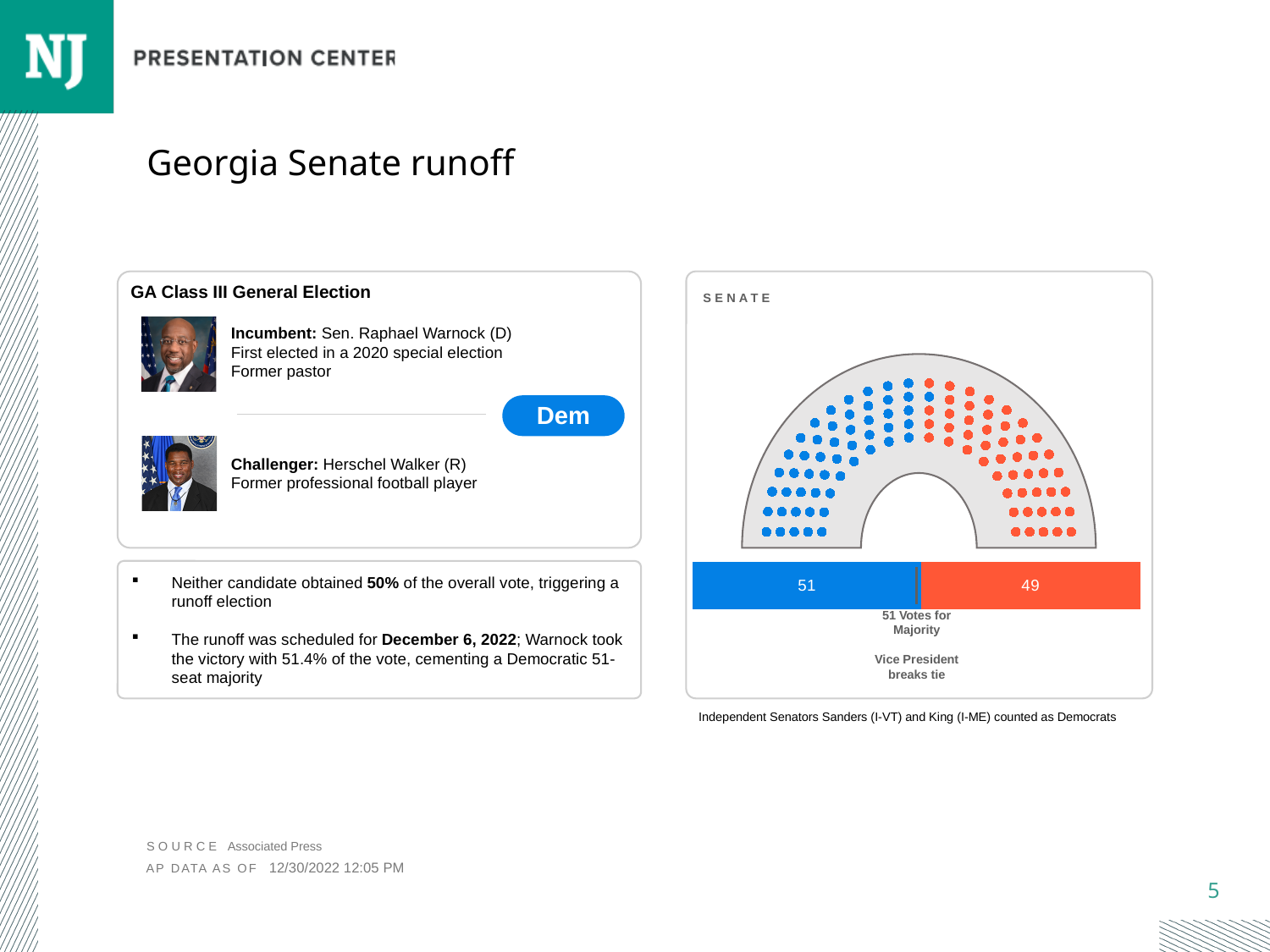
What kind of chart is the bar below the seat diagram in the SENATE chart? stacked bar chart In the SENATE chart, which segment of the bar has the smallest value? orange (49) In the SENATE chart, which segment of the bar has the larger value, the blue one or the orange one? blue In the SENATE chart, what is the total of the two segments in the bar? 100 What is the title of the chart on the right side of the slide? SENATE In the SENATE chart, what is the difference between the blue segment value and the orange segment value? 2 How many segments does the bar below the seat diagram in the SENATE chart have? 2 In the SENATE chart, what value is shown on the blue segment of the bar? 51 According to the label under the bar in the SENATE chart, how many votes are needed for a majority? 51 In the SENATE chart, what value is shown on the orange segment of the bar? 49 In the SENATE chart, which segment of the bar has the highest value? blue (51)